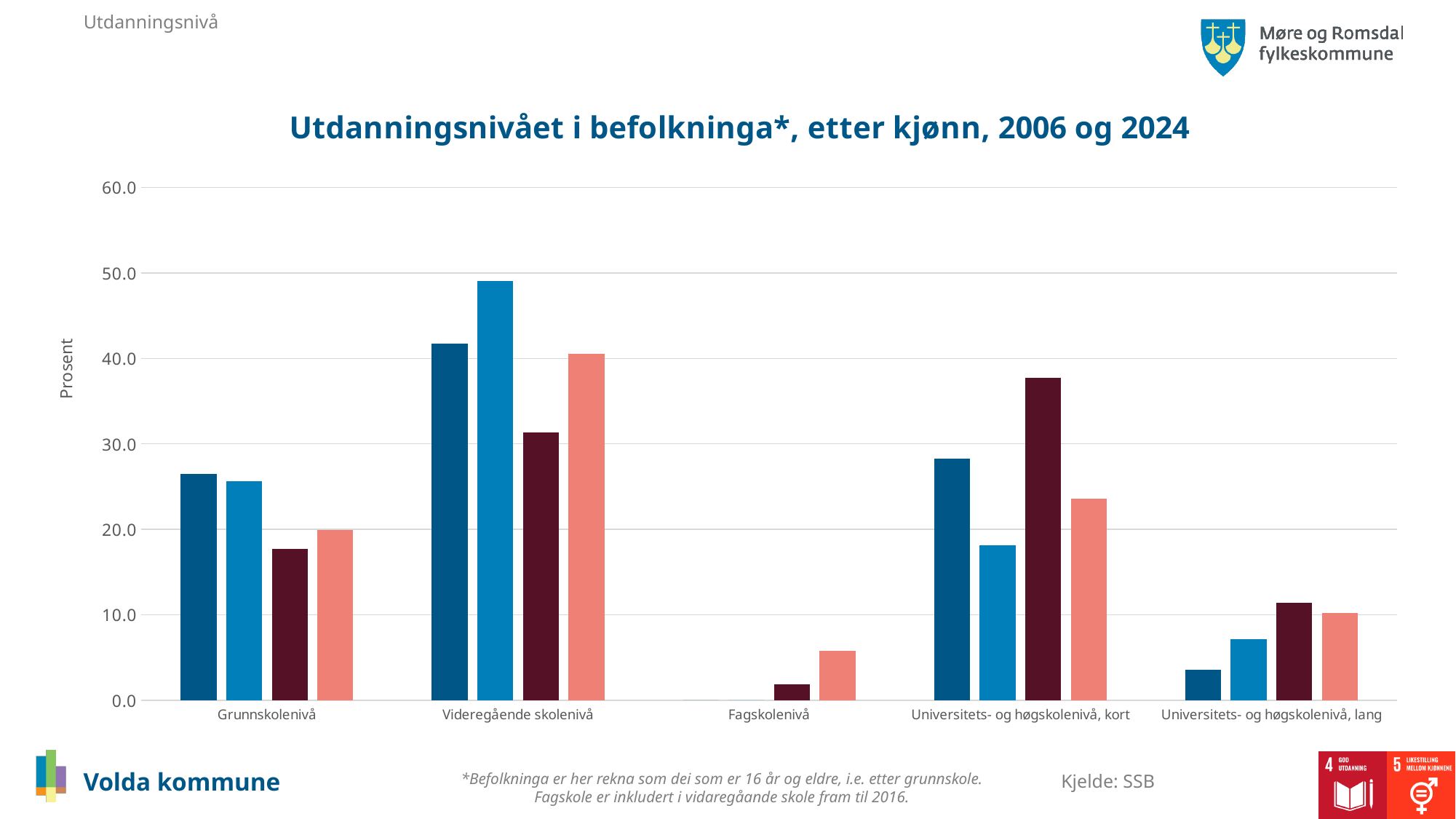
Is the salmon-coloured bar for Fagskolenivå greater or less than 10? less Is the dark red bar for Universitets- og høgskolenivå, kort greater or less than 30? greater For Universitets- og høgskolenivå, lang, which is larger: the light blue bar or the dark red bar? the dark red bar What is the label on the vertical axis of the chart? Prosent What is the title of the chart? Utdanningsnivået i befolkninga*, etter kjønn, 2006 og 2024 Is the light blue bar for Universitets- og høgskolenivå, kort greater or less than 20? less Which category contains the tallest bar in the chart? Videregående skolenivå Which category has the lowest bars overall in the chart? Fagskolenivå For Universitets- og høgskolenivå, kort, which is larger: the dark blue bar or the salmon-coloured bar? the dark blue bar How many education-level categories are shown along the x axis? 5 What kind of chart is shown on the slide? bar chart